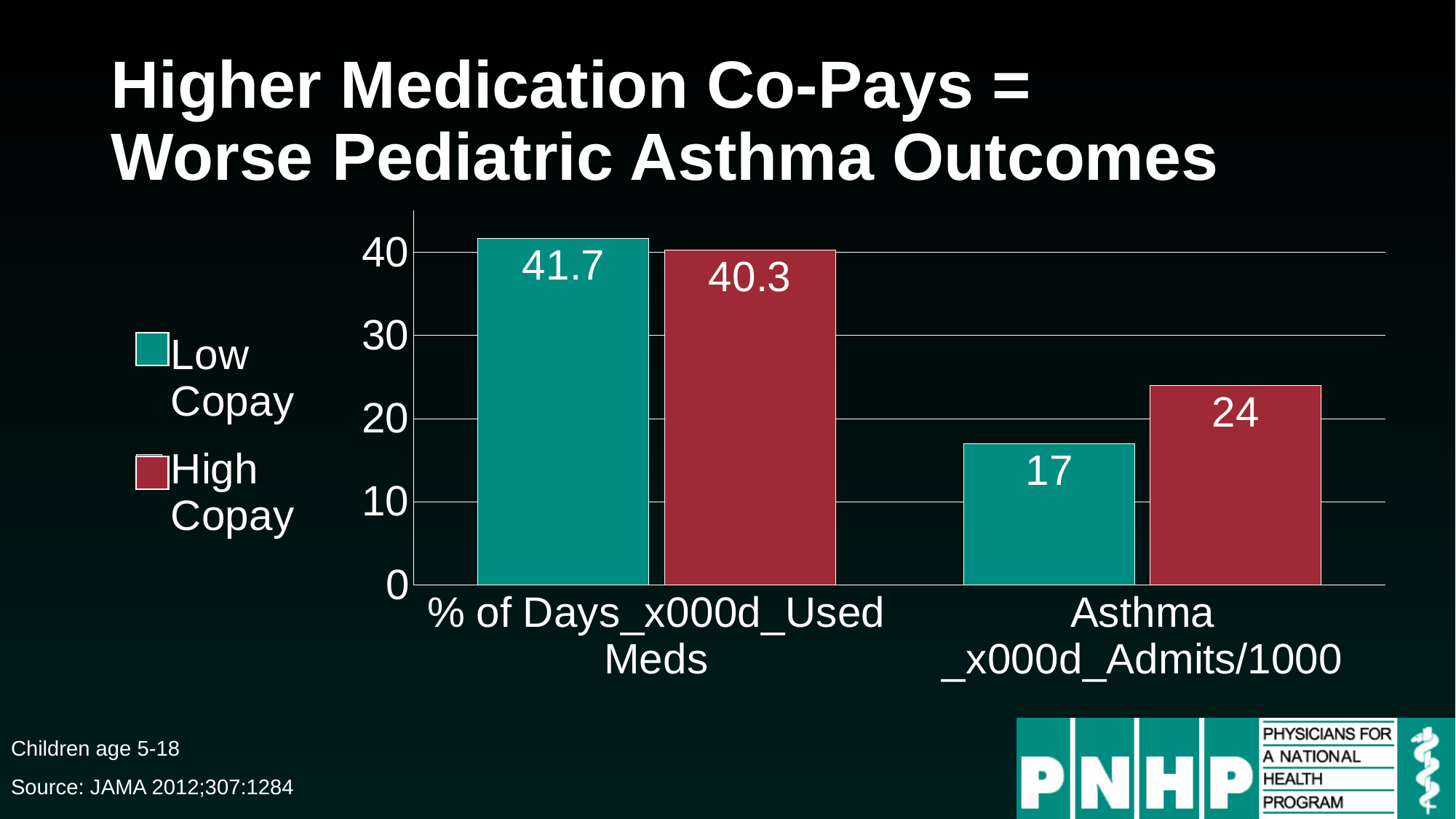
What is the difference between the High Copay and Low Copay values for Asthma Admits/1000? 7 What is the High Copay value for % of Days Used Meds? 40.3 What is the Low Copay value for % of Days Used Meds? 41.7 What is the Low Copay value for Asthma Admits/1000? 17 What is the High Copay value for Asthma Admits/1000? 24 Which bar in the chart has the lowest value? Low Copay, Asthma Admits/1000 (17) Which group has the higher Asthma Admits/1000, Low Copay or High Copay? High Copay What is the difference between the Low Copay and High Copay values for % of Days Used Meds? 1.4 What colour represents the High Copay series? Red How many series does the legend list? 2 What type of chart is shown on the slide? Bar chart Which bar in the chart has the highest value? Low Copay, % of Days Used Meds (41.7)